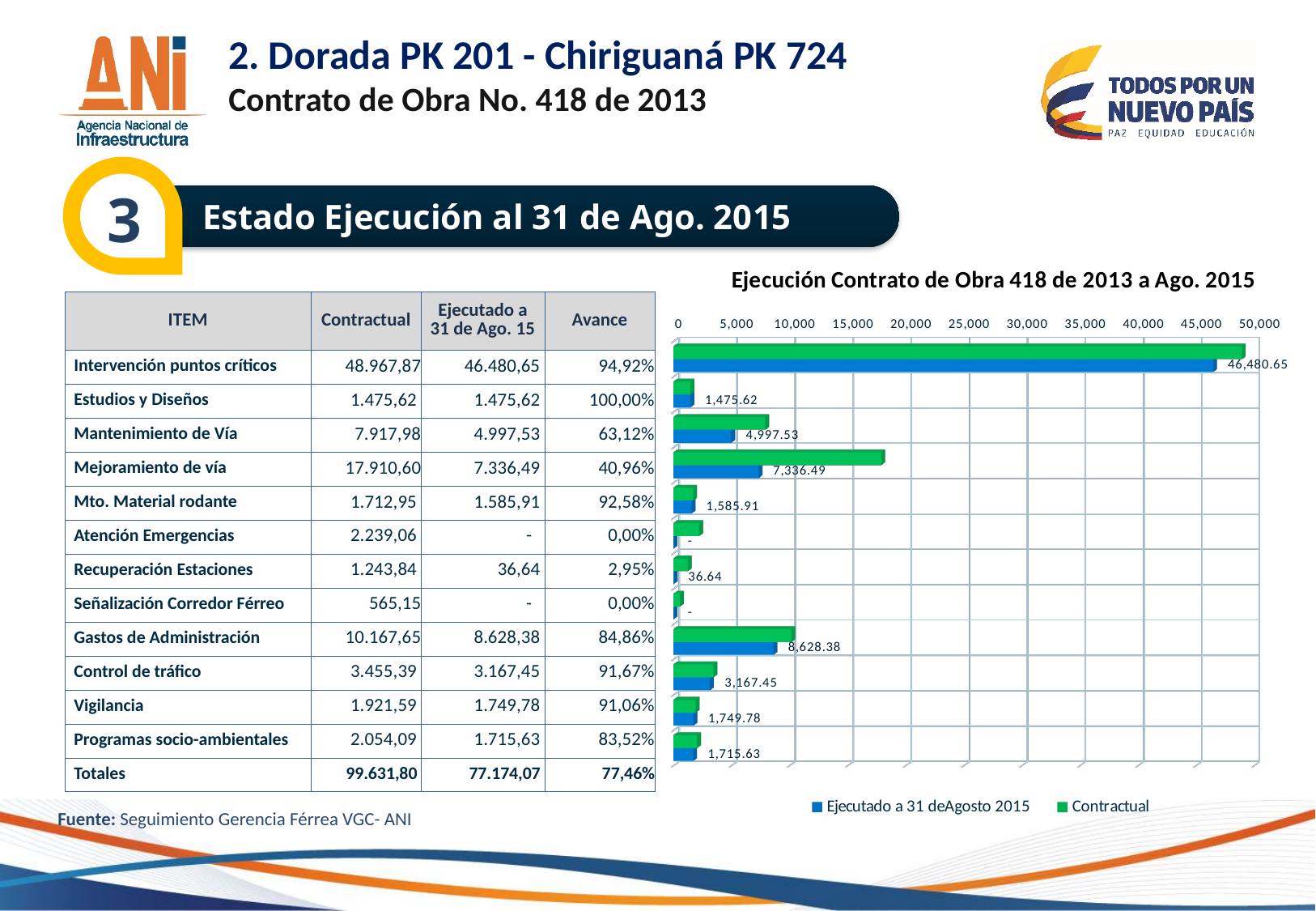
Which series is shown in green in the chart? Contractual What kind of chart is shown on the slide? bar chart What is the title of the chart on the right of the slide? Ejecución Contrato de Obra 418 de 2013 a Ago. 2015 Which is larger in the chart: the Ejecutado value of the fourth group from the top (7,336.49) or of the ninth group from the top (8,628.38)? 8,628.38 (ninth group) How many series does the chart legend list? 2 What is the difference between the Ejecutado data labels 8,628.38 and 7,336.49 in the chart? 1,291.89 Is the Contractual (green) value of the topmost bar group greater or less than 45,000? greater What is the data label on the blue bar in the ninth group from the top of the chart? 8,628.38 How many groups of bars are plotted in the chart? 12 Which group of bars has the highest Ejecutado a 31 de Agosto 2015 value in the chart? the topmost group (46,480.65) What is the data label on the topmost blue bar (Ejecutado a 31 de Agosto 2015) in the chart? 46,480.65 What is the data label on the blue bar in the fourth group from the top of the chart? 7,336.49